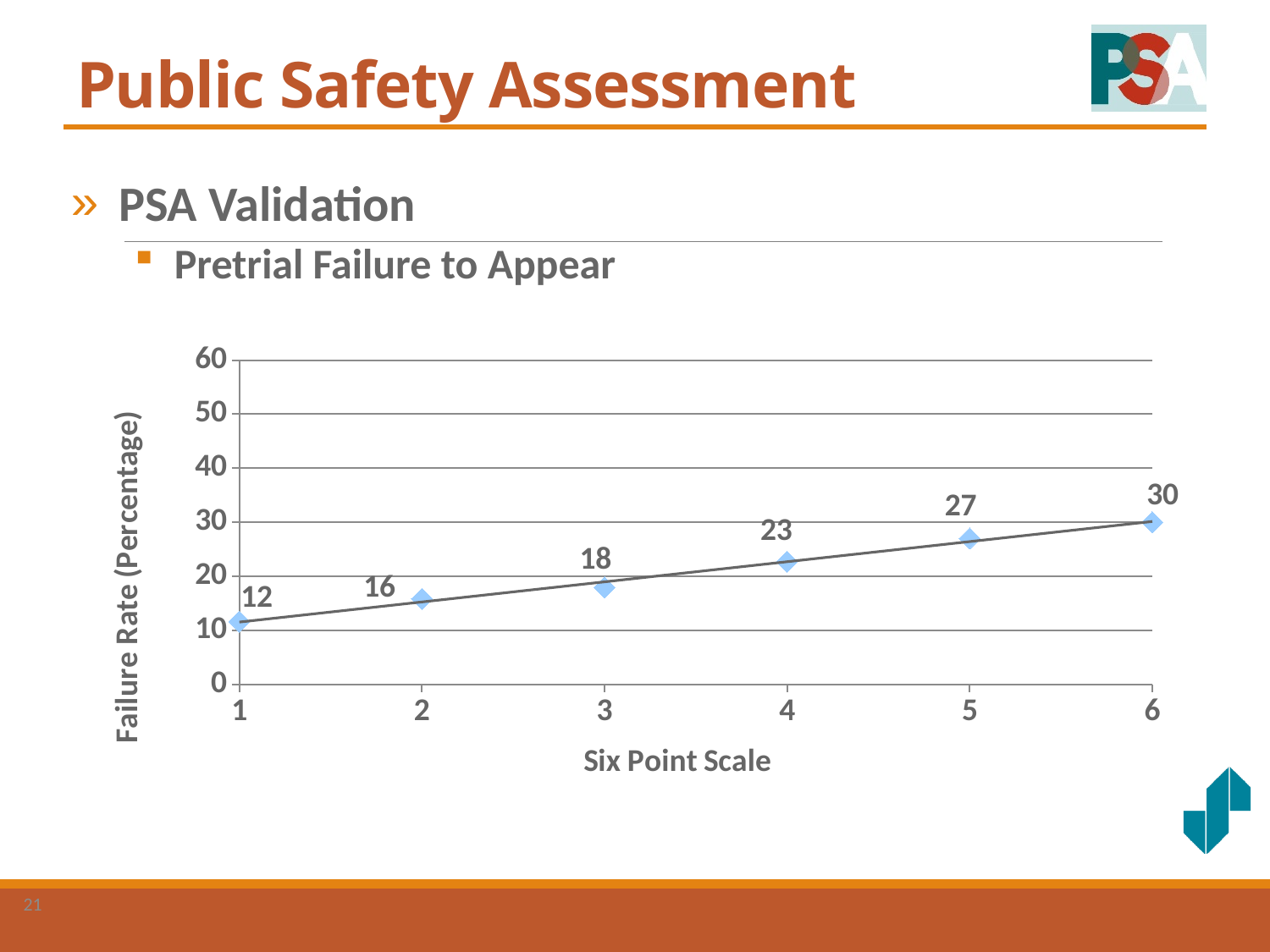
Which point on the six point scale has the lowest failure rate? 1 How many points are plotted on the chart? 6 What is the difference in failure rate between scale point 5 and scale point 3? 9 What is the failure rate for scale point 4? 23 What kind of chart is shown on the slide? line chart Which point on the six point scale has the highest failure rate? 6 Is the failure rate for scale point 4 greater or less than 20? greater What is the difference in failure rate between scale point 6 and scale point 1? 18 What is the failure rate for scale point 1? 12 Does the failure rate rise or fall as the six point scale increases? rise What is the failure rate for scale point 6? 30 Which has a higher failure rate, scale point 2 or scale point 5? 5